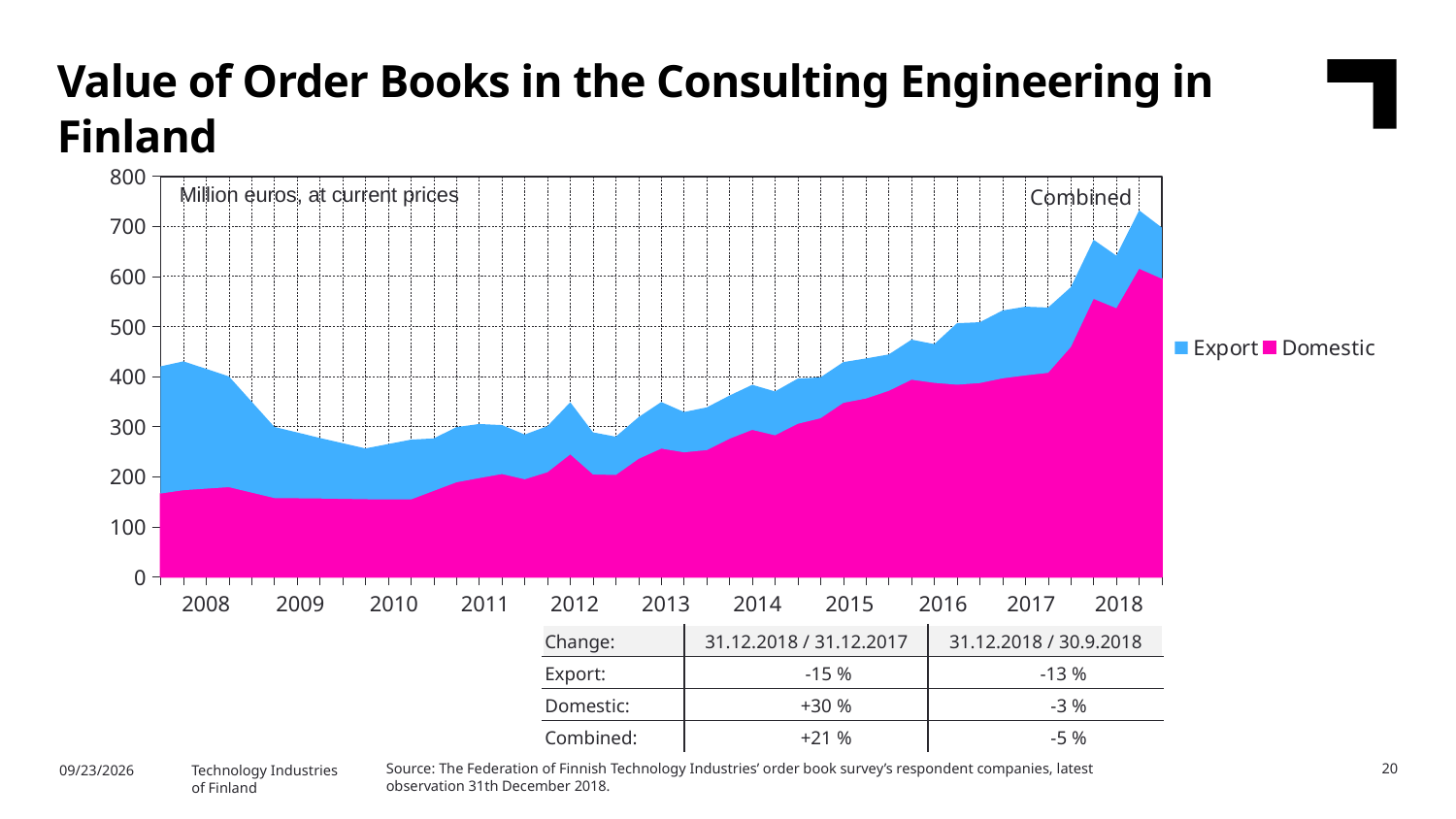
Is the Domestic value at the start of 2008 greater or less than 200? less Which series is larger at the start of 2008, Export or Domestic? Export What unit is stated in the label inside the chart? Million euros, at current prices Is the Domestic value at the end of 2018 greater or less than 500? greater Is the Combined value at the start of 2008 greater or less than 500? less How many years are labelled on the x axis? 11 Which series is larger at the end of 2018, Export or Domestic? Domestic Does the Domestic value rise or fall from 2013 to 2018? rise How many series does the legend list? 2 What is the title of the slide's chart? Value of Order Books in the Consulting Engineering in Finland What kind of chart is shown on the slide? Area chart